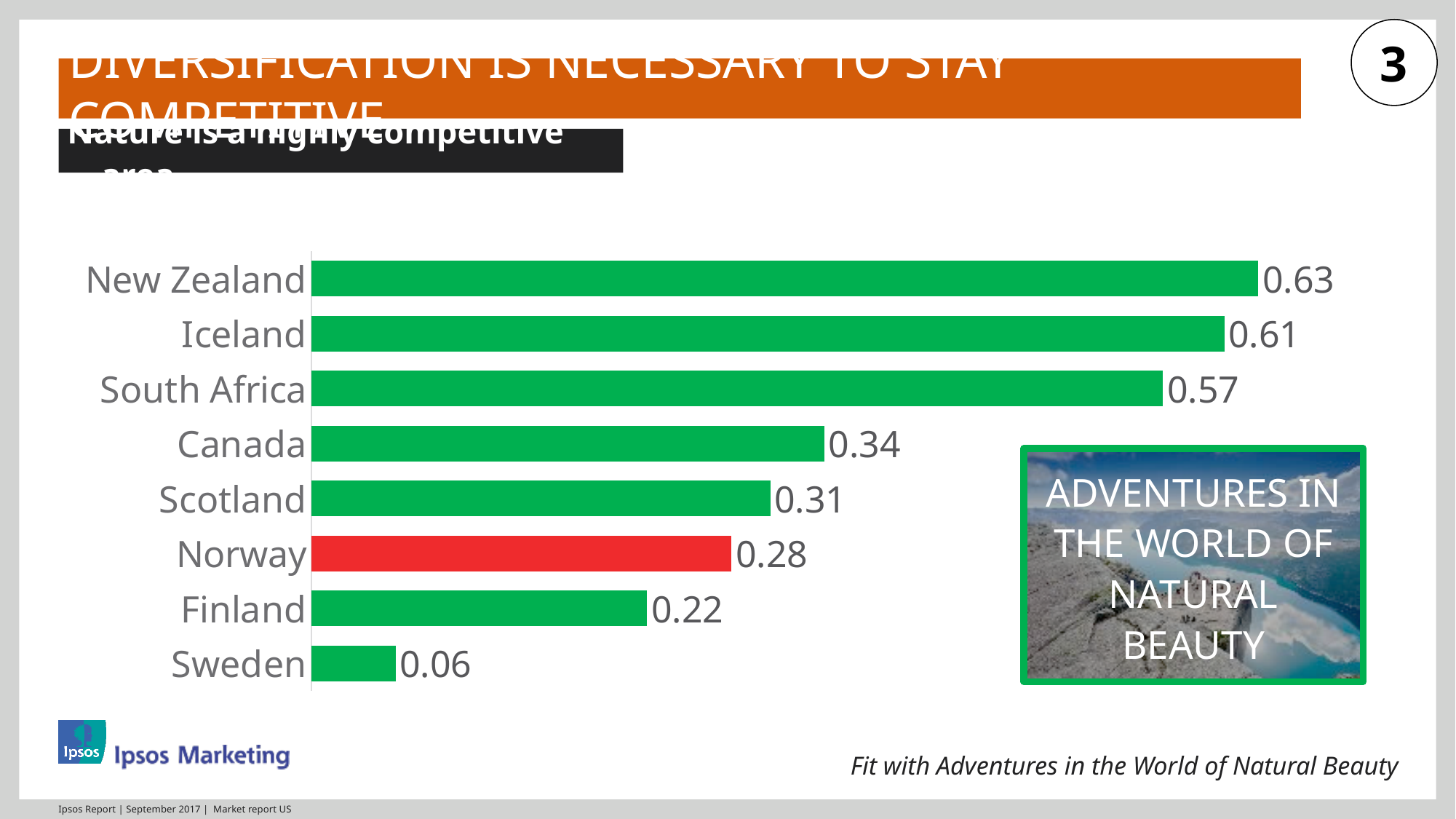
What is the value for Canada? 0.34 What is the value for Norway? 0.28 What is the difference between the values for New Zealand and Norway? 0.35 What is the difference between the values for Iceland and South Africa? 0.04 What kind of chart is shown on the slide? Bar chart Which country's bar is coloured red rather than green? Norway What is the value for Sweden? 0.06 Which country has the highest value? New Zealand How many countries are shown in the chart? 8 What is the value for New Zealand? 0.63 Which has a larger value, Scotland or Finland? Scotland Which country has the lowest value? Sweden